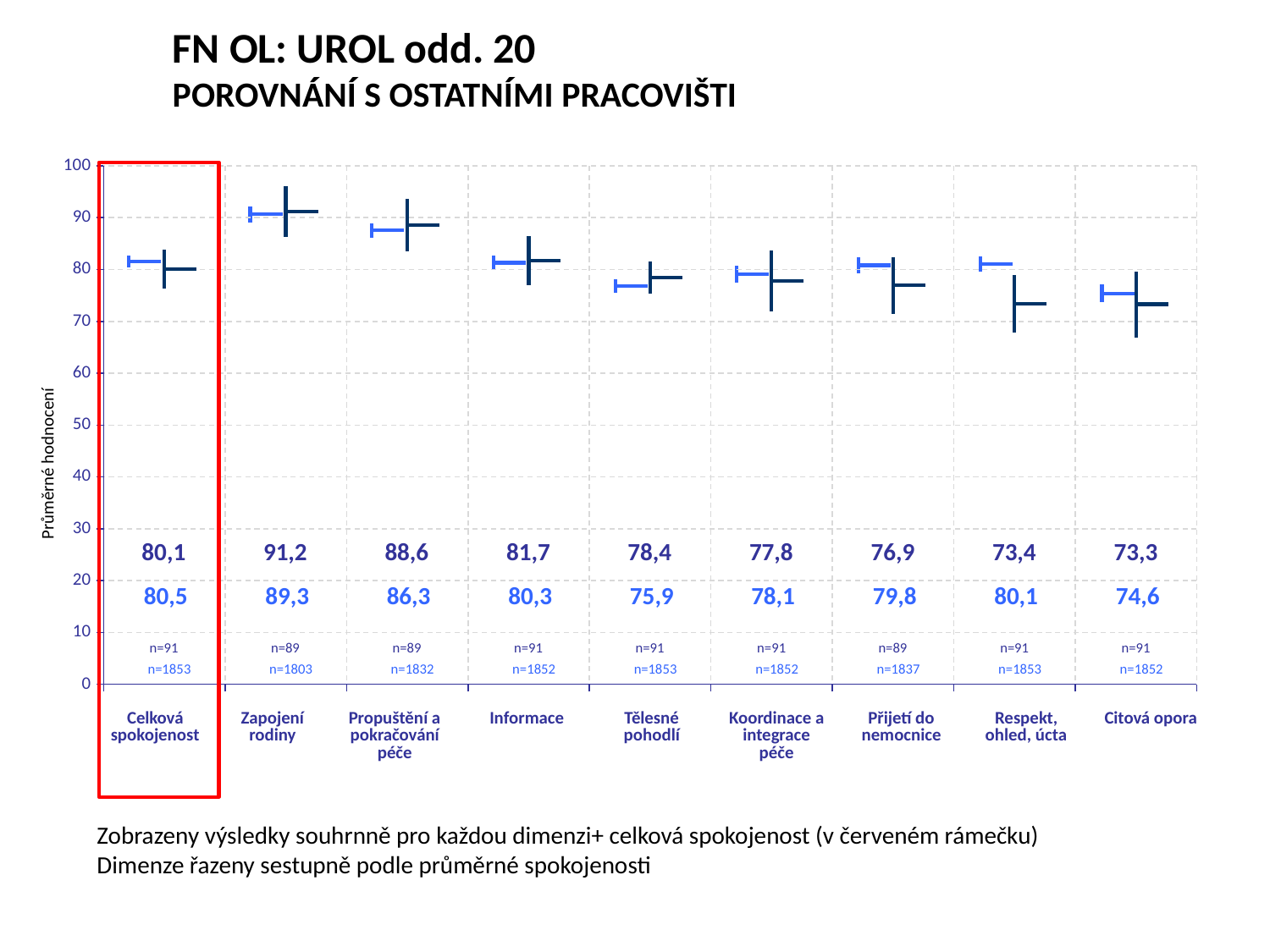
Is the dark blue value for Propuštění a pokračování péče greater or less than 80? greater Which dimension has the lowest dark blue value? Citová opora Which dimension has the highest dark blue value? Zapojení rodiny How many dimensions (categories) are shown on the x axis? 9 What is the label of the y axis? Průměrné hodnocení What is the dark blue value printed for Celková spokojenost? 80,1 What is the dark blue value printed for Zapojení rodiny? 91,2 What is the light blue value printed for Respekt, ohled, úcta? 80,1 Which dimension has the lowest light blue value? Citová opora Which is larger for Přijetí do nemocnice: the dark blue value or the light blue value? the light blue value (79,8) What is the difference between the dark blue and light blue values for Respekt, ohled, úcta? 6,7 What is the n value printed in dark blue for Informace? n=91